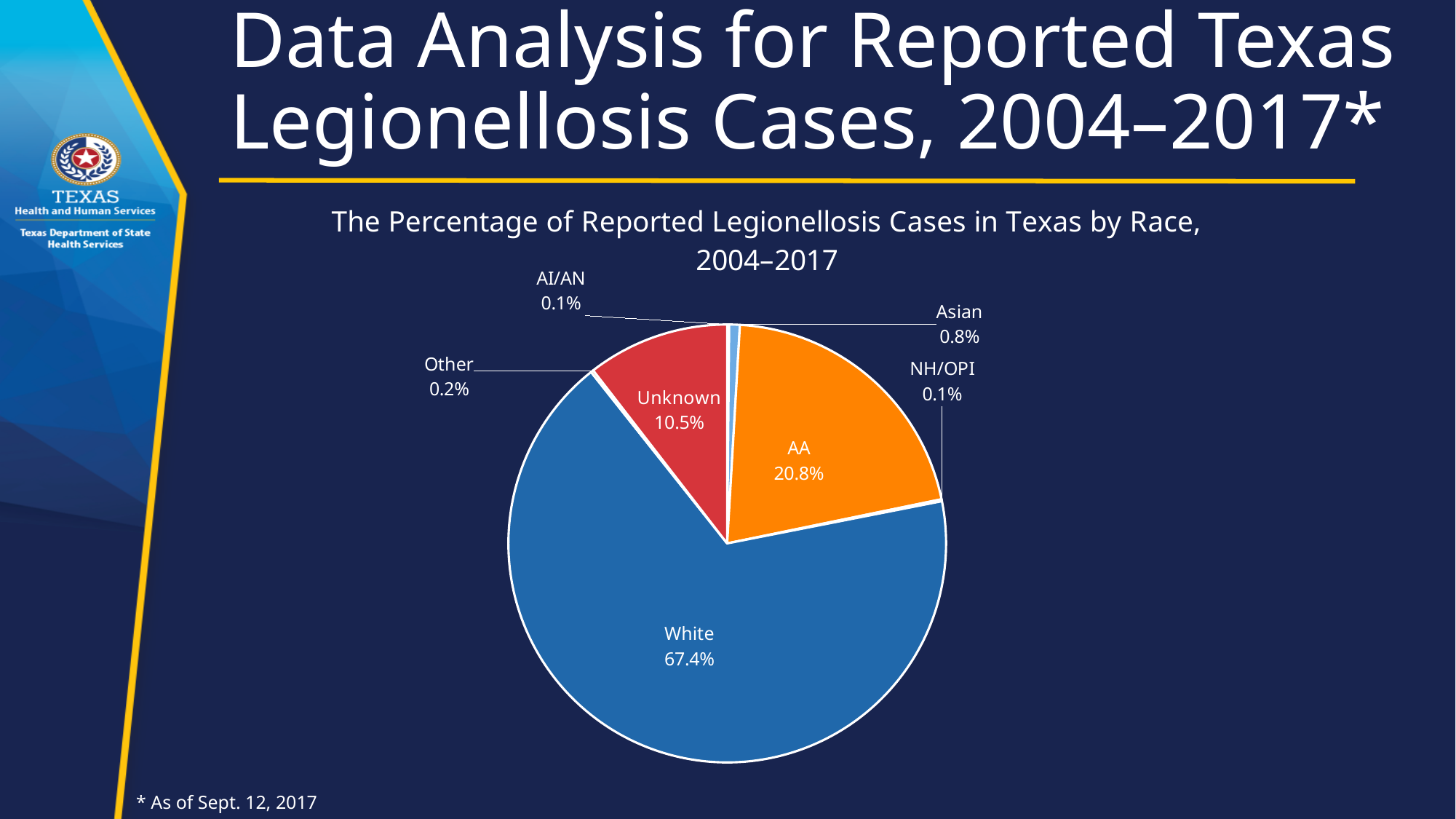
What percentage is shown for the Other category? 0.2% What colour is the AA slice of the pie chart? Orange What percentage of cases were Asian? 0.8% Which race category has the largest share of reported cases? White What is the percentage for the Unknown category? 10.5% Which category has a larger share, AA or Unknown? AA What percentage of reported legionellosis cases in Texas were White? 67.4% How many categories are shown in the pie chart? 7 What percentage of cases does the AA slice represent? 20.8% What is the difference in percentage points between the White and AA slices? 46.6 What type of chart is shown on the slide? Pie chart What is the title of the chart? The Percentage of Reported Legionellosis Cases in Texas by Race, 2004–2017